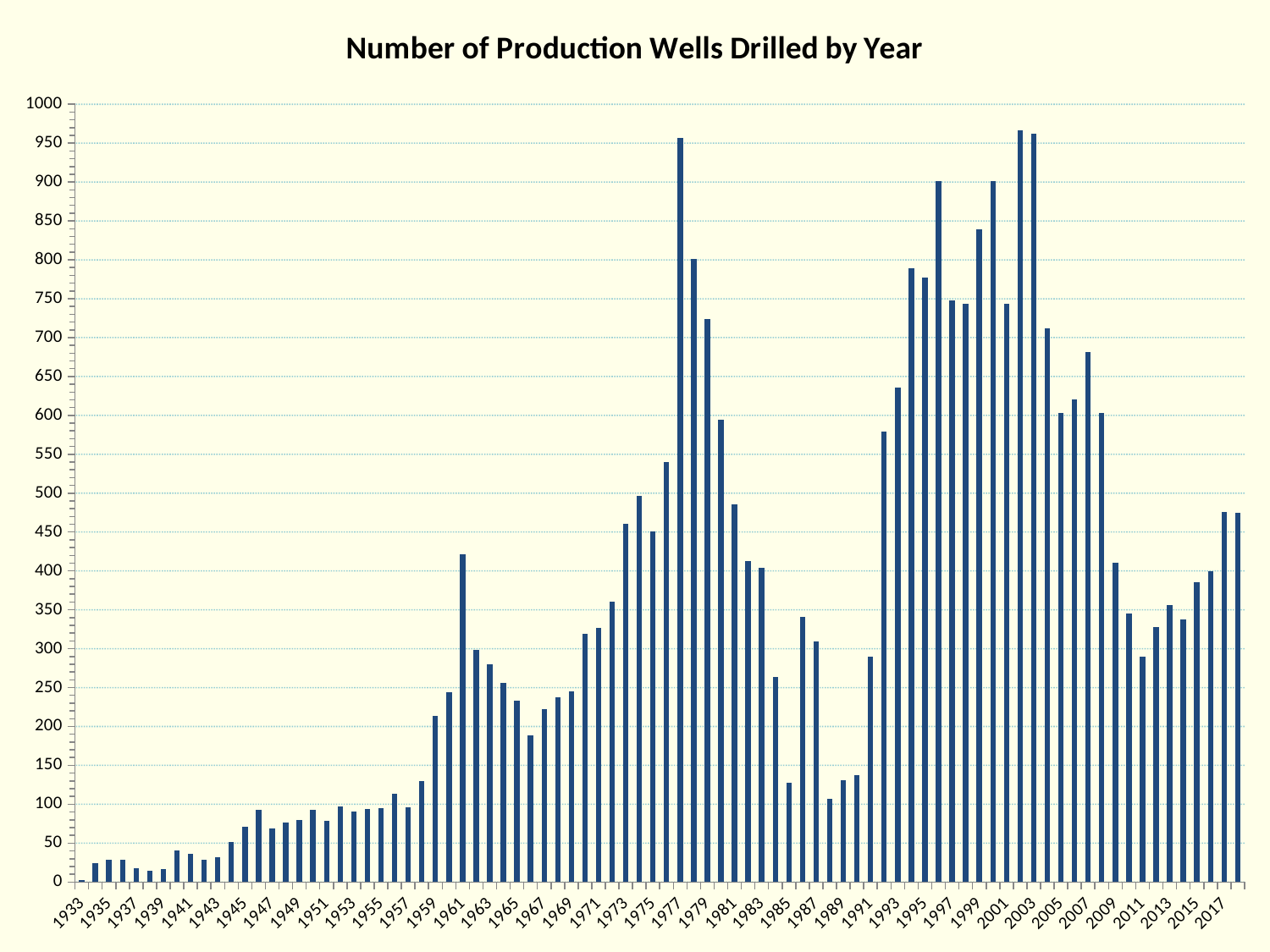
Is the value for 1993 greater or less than 600? greater Is the value for 1961 greater or less than 400? greater Is the value for 2010 greater or less than 400? less Which year has the lowest number of production wells drilled? 1933 What kind of chart is shown on the slide? bar chart Which year has the higher value, 2004 or 2005? 2004 Do the values generally rise or fall from 1933 to 1945? rise Which year has the higher value, 1977 or 1978? 1977 What is the title of the chart? Number of Production Wells Drilled by Year